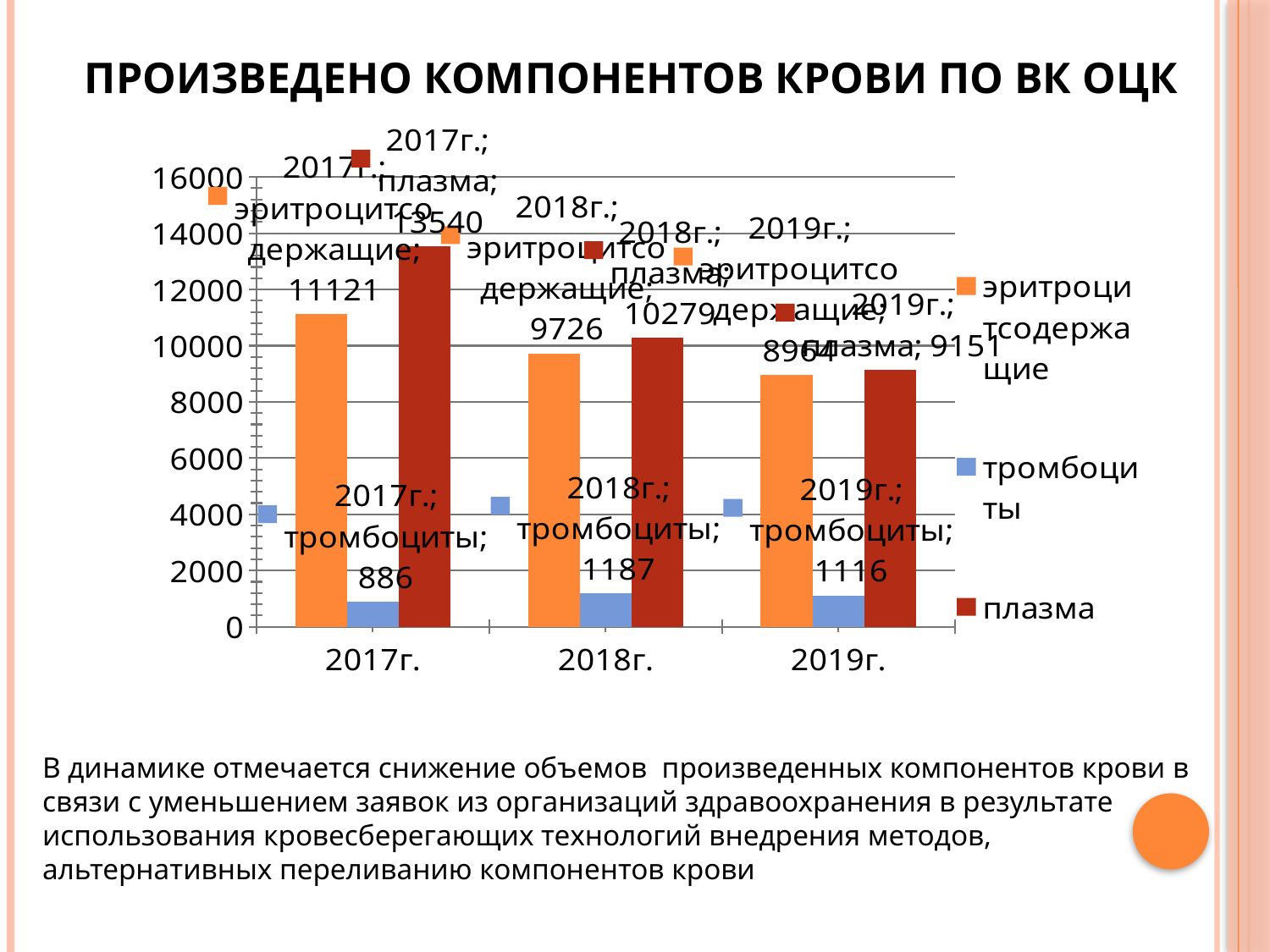
What is the value for плазма in 2019г.? 9151 What type of chart is shown on the slide? bar chart How many series does the legend list? 3 What is the value for тромбоциты in 2018г.? 1187 In which year was the плазма value highest? 2017г. Which is larger in 2018г.: плазма or эритроцитсодержащие? плазма Is the value for эритроцитсодержащие in 2019г. greater or less than 10000? less In which year was the тромбоциты value lowest? 2017г. How many year categories are shown on the x axis? 3 What is the value for эритроцитсодержащие in 2018г.? 9726 What is the difference between the плазма values for 2017г. and 2018г.? 3261 What is the value for плазма in 2017г.? 13540